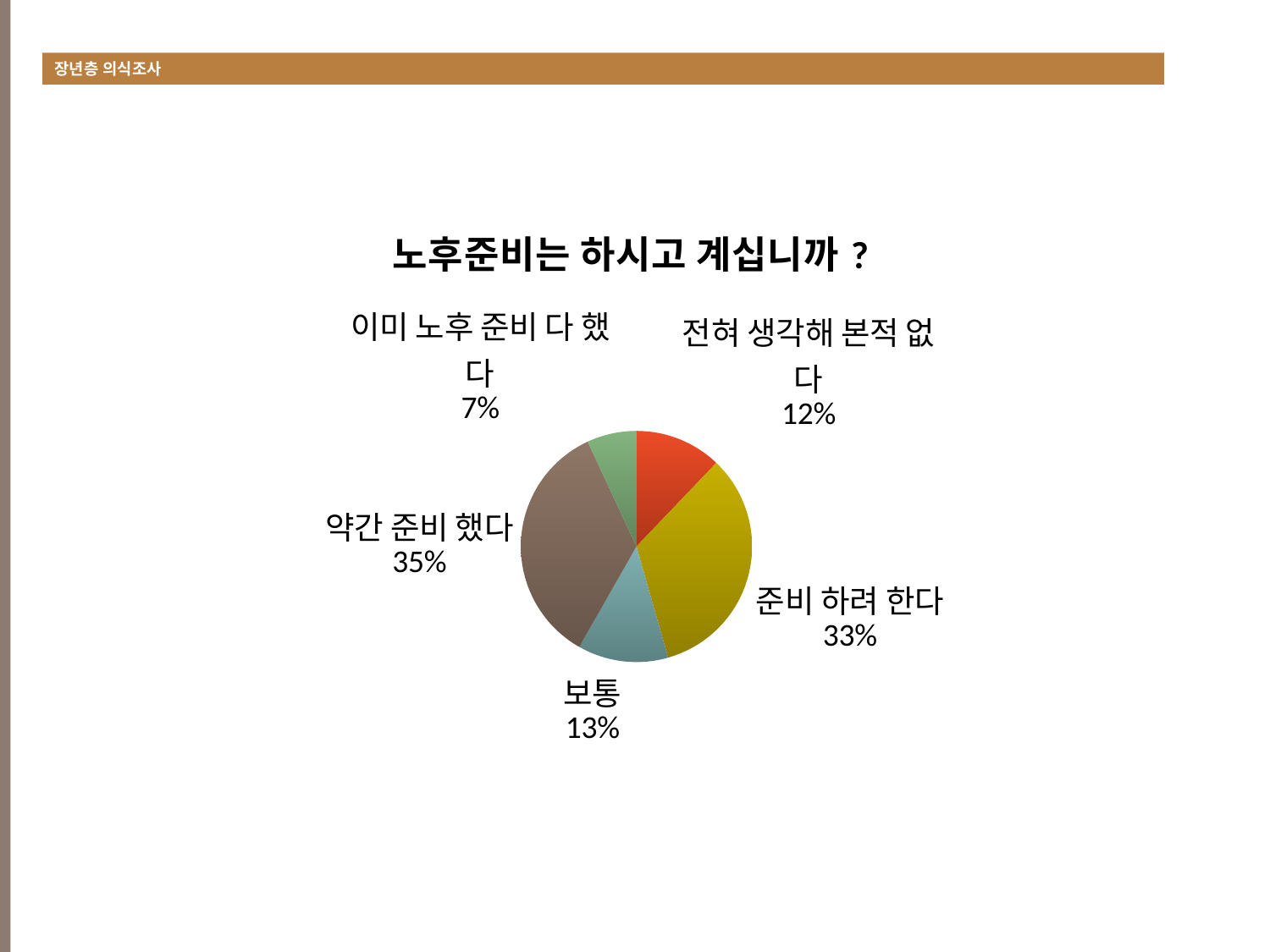
Which is larger, the share for 보통 or the share for 이미 노후 준비 다 했다? 보통 What is the title of the chart? 노후준비는 하시고 계십니까 ? What percentage of respondents answered 준비 하려 한다? 33% Which category has the largest share of the pie? 약간 준비 했다 What is the difference in percentage points between 약간 준비 했다 and 보통? 22 What percentage of respondents answered 약간 준비 했다? 35% What type of chart is shown on the slide? pie chart What share of the pie is 보통? 13% How many categories are shown in the pie chart? 5 What percentage is shown for 이미 노후 준비 다 했다? 7% Which category has the smallest share of the pie? 이미 노후 준비 다 했다 What percentage is shown for 전혀 생각해 본적 없다? 12%